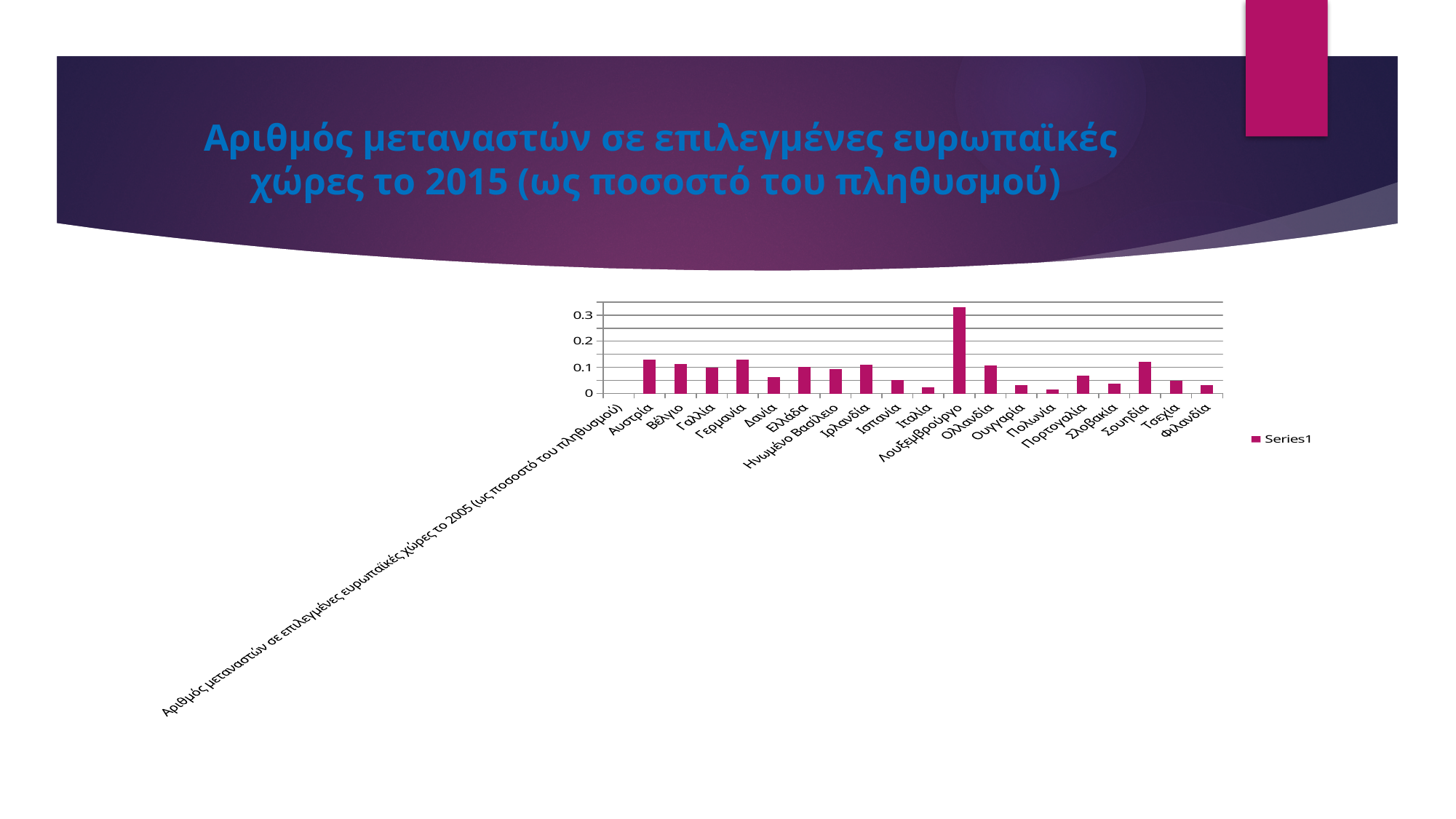
Is the value for Αυστρία greater or less than 0.1? greater Is the value for Ιταλία greater or less than 0.1? less What is the name of the series shown in the legend? Series1 Which has the larger value, Λουξεμβούργο or Γερμανία? Λουξεμβρούργο Which has the larger value, Αυστρία or Δανία? Αυστρία Is the value for Λουξεμβούργο greater or less than 0.2? greater How many series does the legend list? 1 Which has the larger value, Ισπανία or Ιταλία? Ισπανία Which country has the highest value in the chart? Λουξεμβρούργο What kind of chart is shown on the slide? Bar chart Which country has the lowest value in the chart? Πολωνία